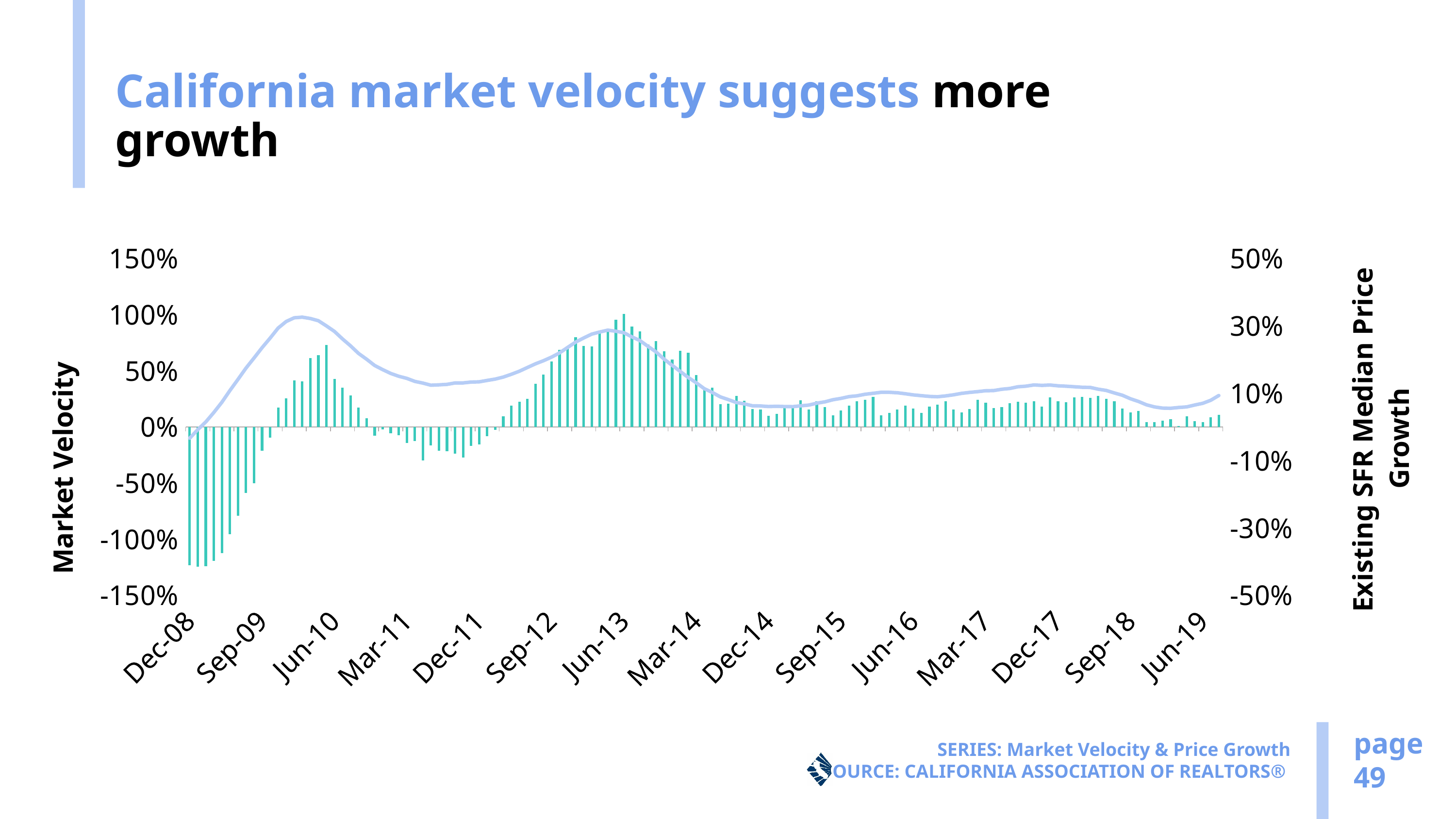
What is the title of the right vertical axis? Existing SFR Median Price Growth How many date labels are shown along the x axis? 15 Which has the higher Market Velocity bar value, Dec-08 or Jun-13? Jun-13 Is the Existing SFR Median Price Growth line value at Jun-13 greater or less than 10%? greater Is the Existing SFR Median Price Growth line value at Dec-08 greater or less than 10%? less Does the Existing SFR Median Price Growth line rise or fall from Jun-13 to Dec-14? fall What kind of chart is shown on the slide? A combined bar and line chart Does the Market Velocity bar series rise or fall from Dec-08 to Jun-10? rise What is the title of the left vertical axis? Market Velocity